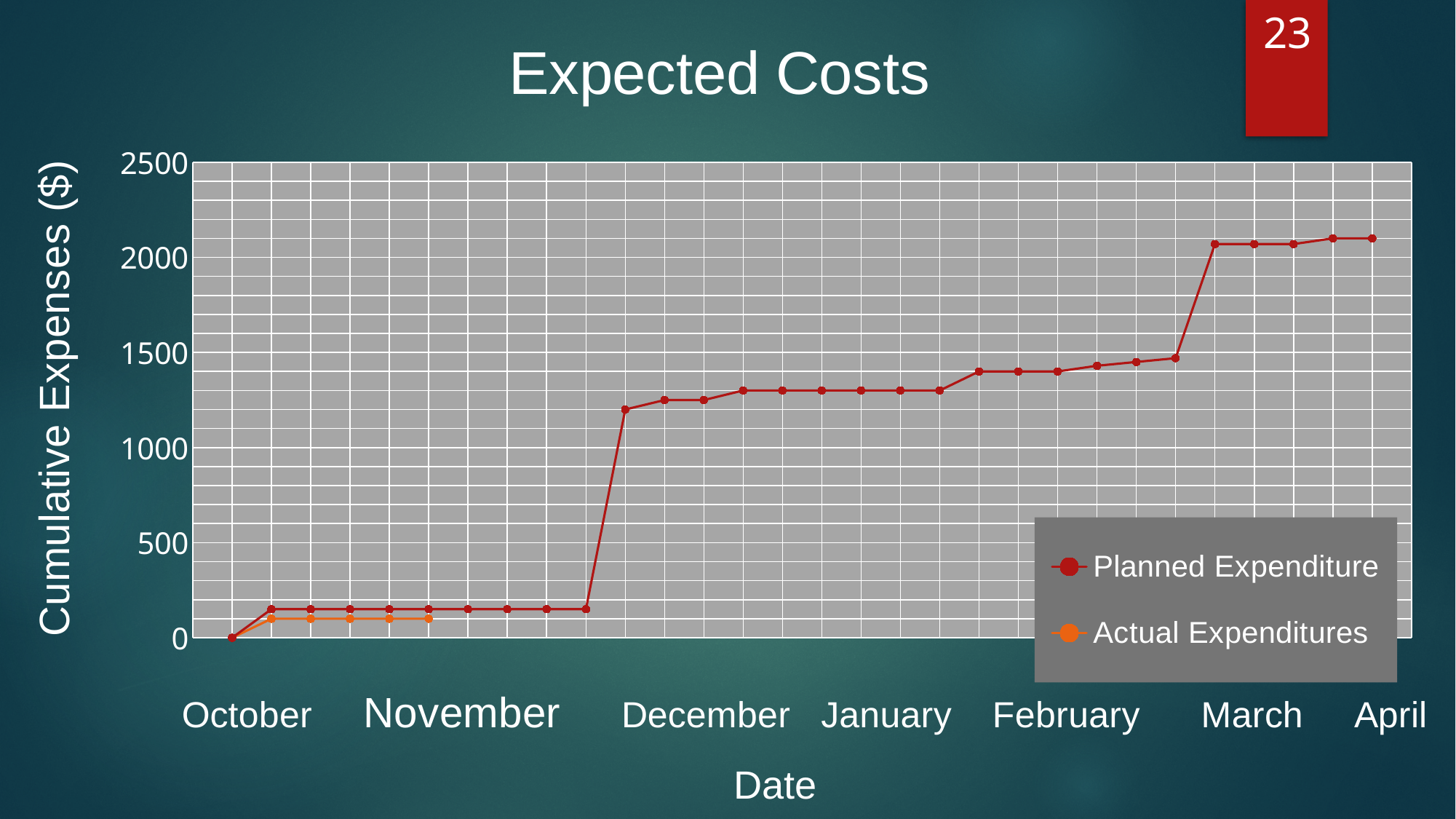
Is the Planned Expenditure value in November greater or less than 500? less How many series does the legend list? 2 Is the Planned Expenditure value in January greater or less than 1500? less How many month labels are shown along the x axis? 7 What is the title of the chart? Expected Costs Is the Planned Expenditure value in April greater or less than 2000? greater In November, which series has the higher value, Planned Expenditure or Actual Expenditures? Planned Expenditure What kind of chart is shown on the slide? line chart In which month does the Planned Expenditure line reach its highest value? April What is the label on the vertical axis? Cumulative Expenses ($) Does the Planned Expenditure line rise or fall from October to April? rise